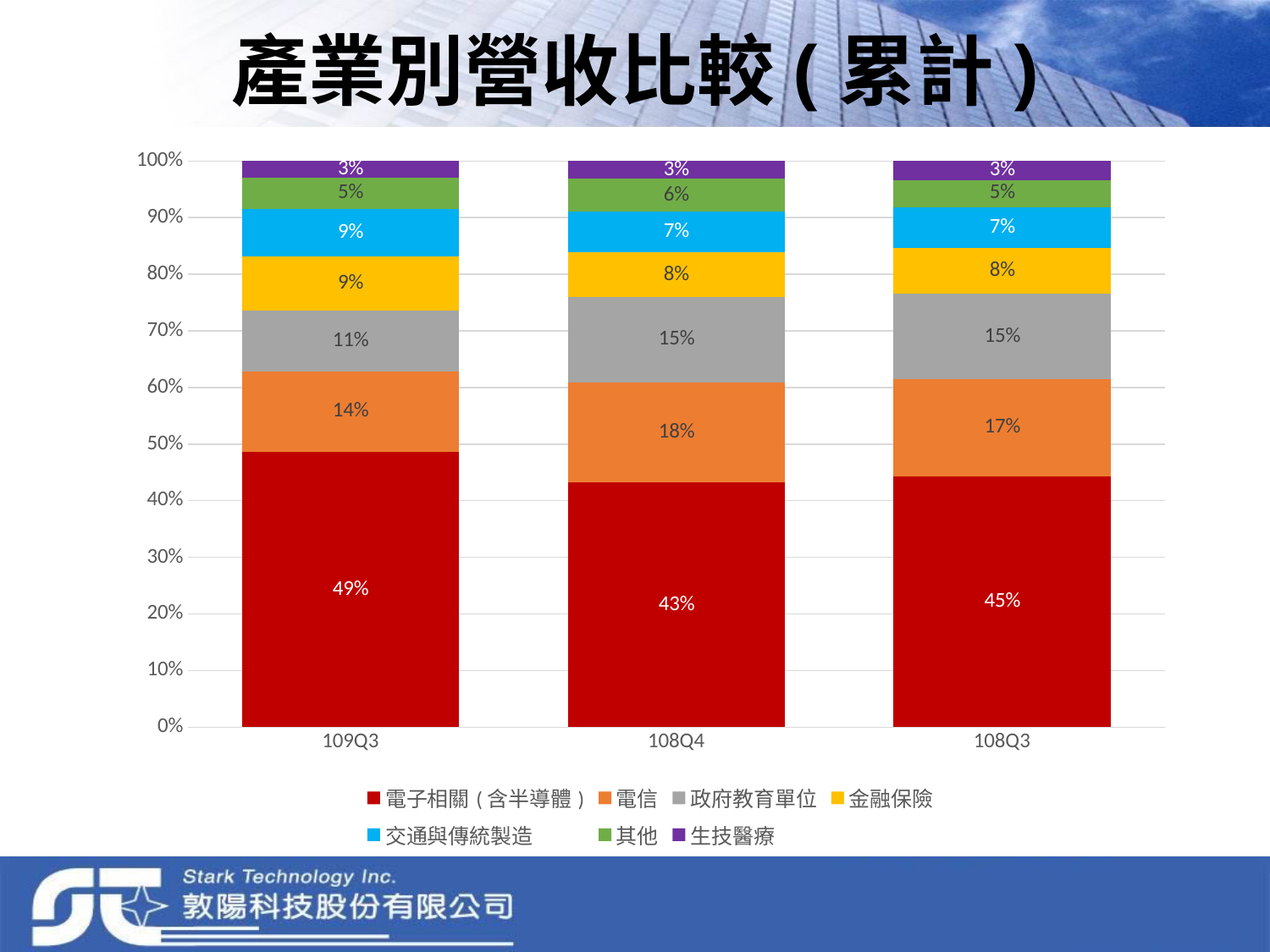
What is the title of the chart? 產業別營收比較（累計） How many periods (bars) are shown on the x axis? 3 What is the value for 政府教育單位 in 108Q3? 15% What is the difference between the 電子相關（含半導體） share in 109Q3 and in 108Q4? 6% Which is larger: the 政府教育單位 share in 109Q3 or in 108Q4? 108Q4 What is the value for 電信 in 108Q4? 18% What share does 電子相關（含半導體） have in the 109Q3 bar? 49% In which period is the 電信 share the lowest? 109Q3 What kind of chart is shown on the slide? Stacked bar chart In which period is the 電子相關（含半導體） share the highest? 109Q3 How many series does the legend list? 7 What is the value for 交通與傳統製造 in 109Q3? 9%